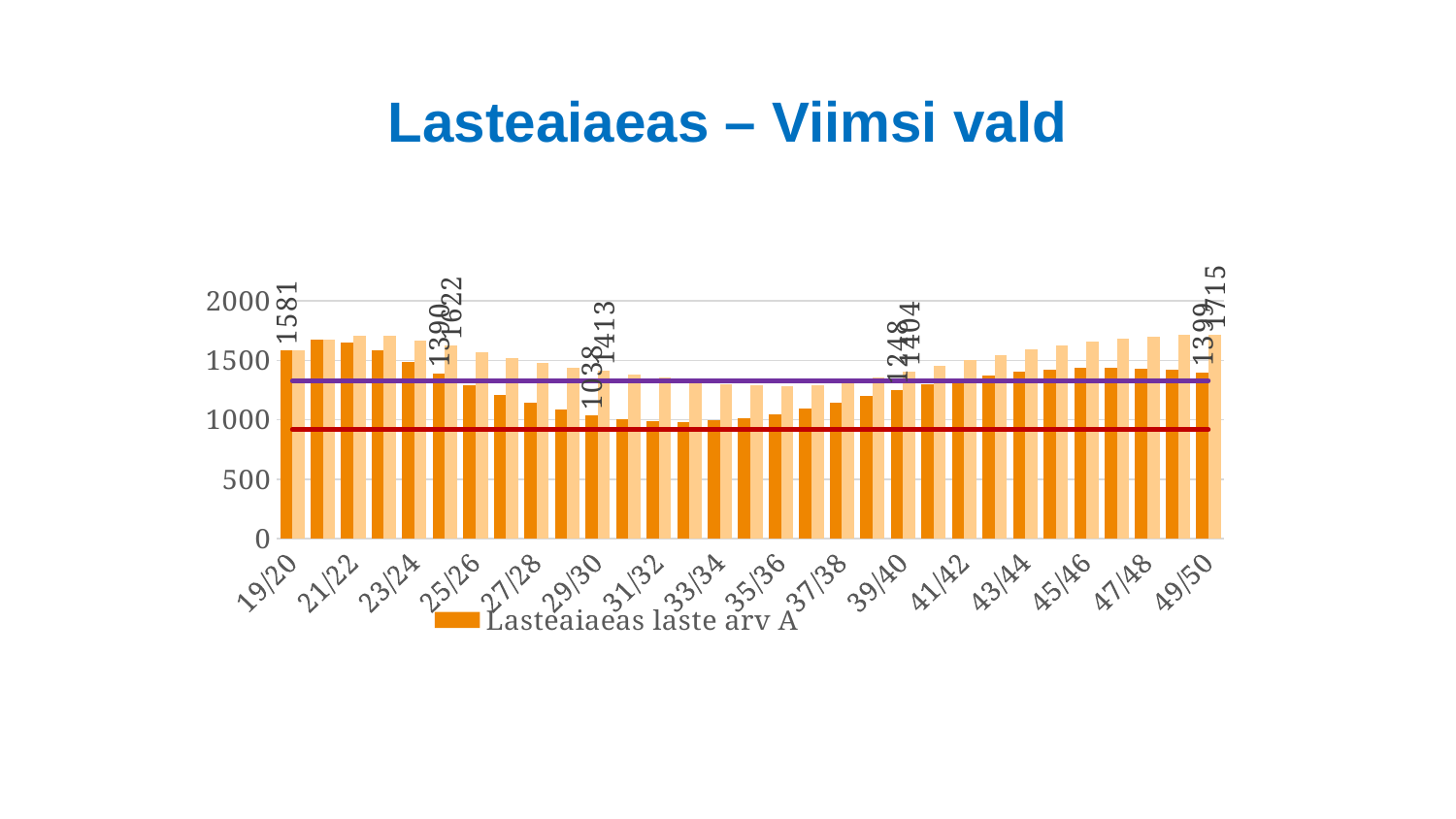
What kind of chart is shown on the slide? combination bar and line chart What is the difference between the two labeled values for 49/50 (1715 and 1399)? 316 What is the labeled value of the dark orange bar for 39/40? 1248 Which is larger: the labeled dark orange value for 19/20 or for 49/50? 19/20 (1581) What is the labeled value of the dark orange bar for 19/20? 1581 What is the difference between the two labeled values for 24/25 (1622 and 1390)? 232 What is the title of the chart? Lasteaiaeas – Viimsi vald Do the dark orange bars rise or fall from 19/20 to 29/30? fall Is the value of the dark orange bar for 21/22 greater or less than 1500? greater What is the labeled value of the light orange bar for 49/50? 1715 What is the difference between the two labeled values for 29/30 (1413 and 1038)? 375 What is the labeled value of the dark orange bar for 29/30? 1038